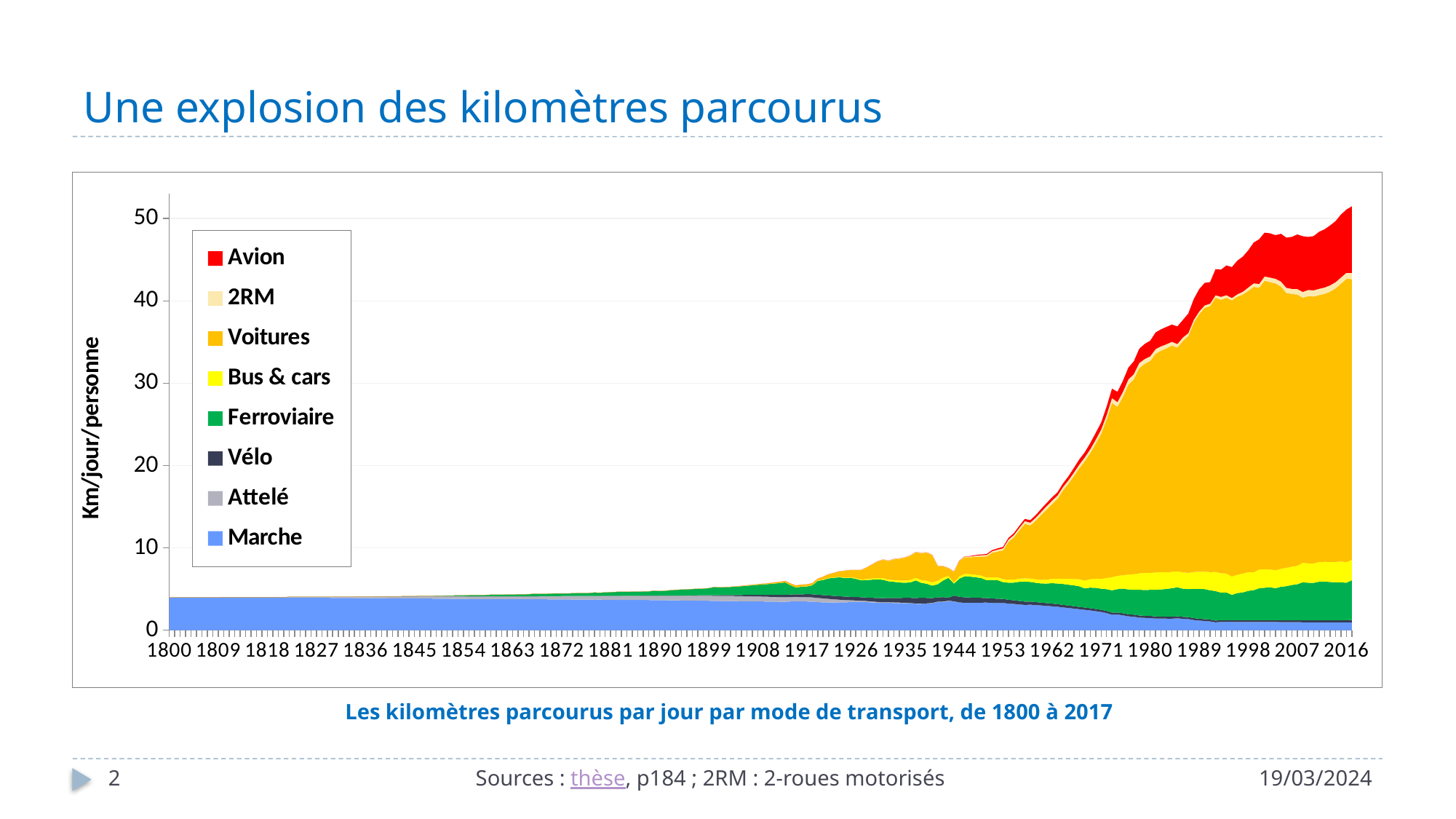
Which colour represents the 'Avion' series in the chart? Red Is the total value for 1980 greater or less than 30? greater What kind of chart is shown on the slide? Stacked area chart Is the total value for 1899 greater or less than 10? less How many series does the chart's legend list? 8 How many year labels are shown along the x axis? 25 What is the label on the vertical axis of the chart? Km/jour/personne Is the value for Marche larger in 1800 or in 2016? 1800 Does the total number of kilometres per day per person rise or fall from 1800 to 2016? Rise Is the total value for 2016 greater or less than 40? greater In 2016, which series contributes more kilometres per day: Voitures or Avion? Voitures